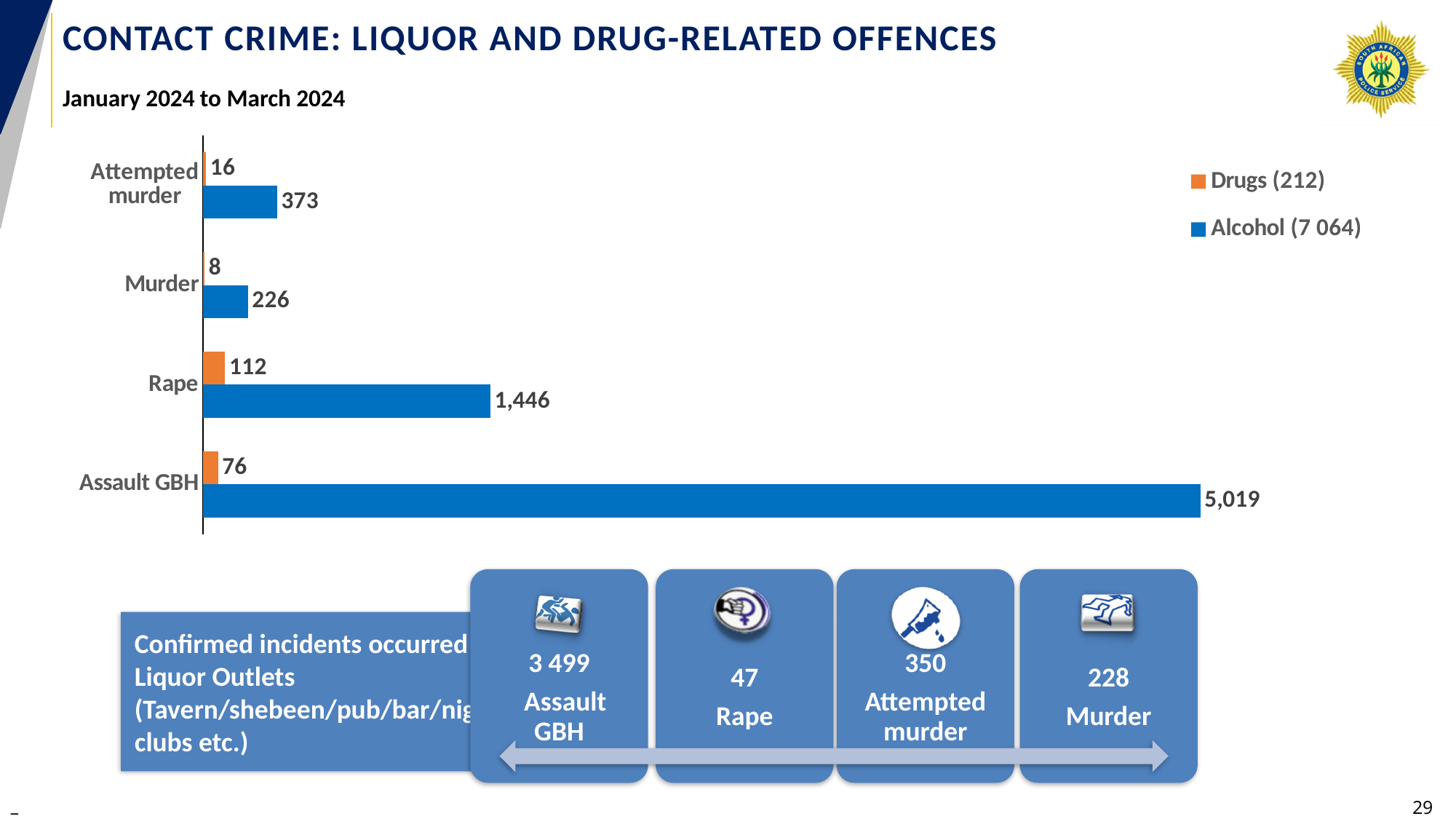
What is the Drugs value for Murder? 8 What total is shown in the legend for the Alcohol series? 7 064 What is the Drugs value for Rape? 112 What is the Alcohol value for Assault GBH? 5,019 Which category has the lowest Drugs value? Murder What is the Alcohol value for Attempted murder? 373 How many categories are shown on the chart? 4 How many series does the legend list? 2 What is the difference between the Alcohol and Drugs values for Rape? 1,334 Which is larger: the Alcohol value for Murder or the Alcohol value for Attempted murder? Attempted murder What kind of chart is shown on the slide? Bar chart Which category has the highest Alcohol value? Assault GBH